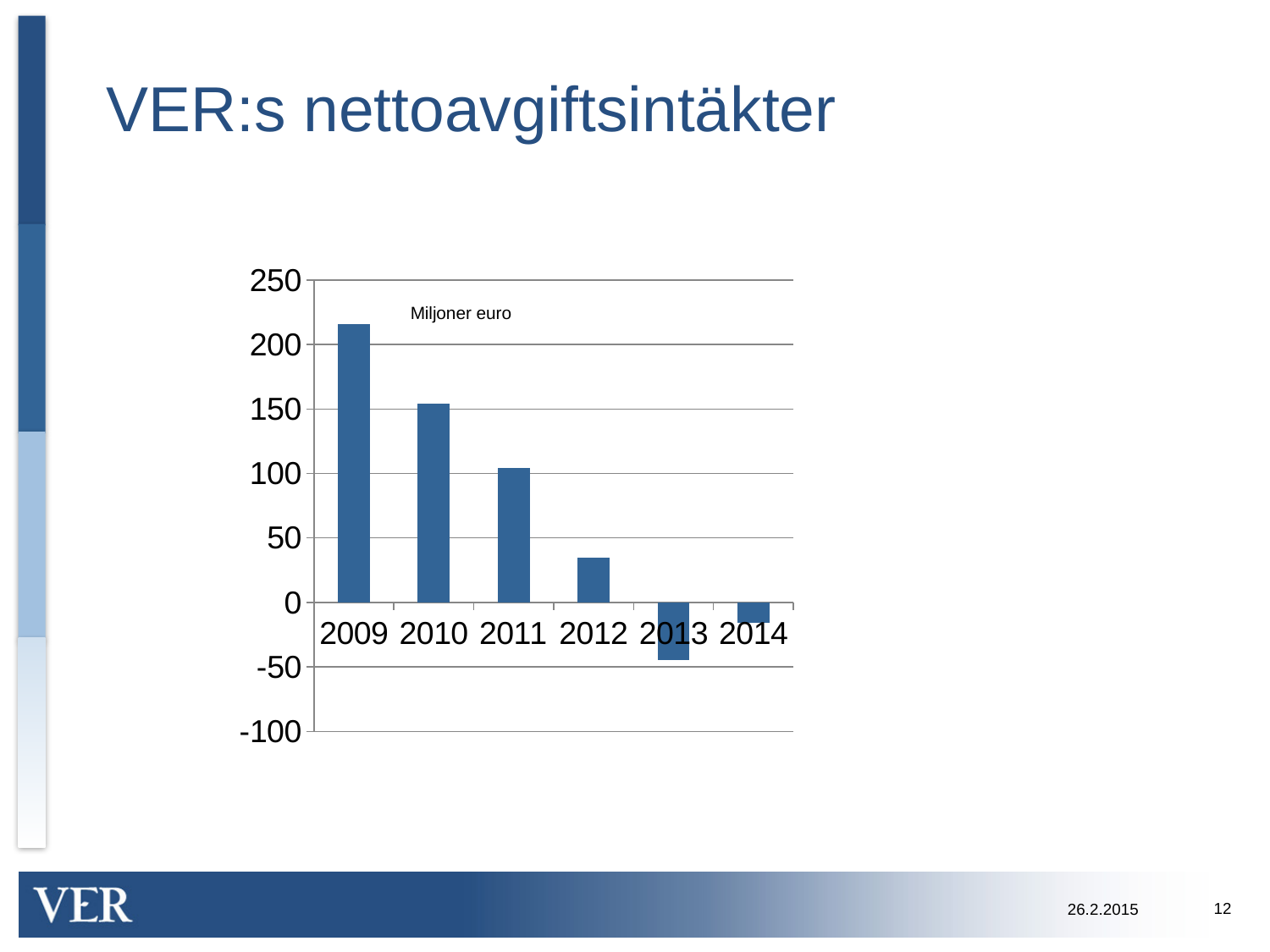
What kind of chart is shown on the slide? bar chart Is the value for 2009 greater or less than 200? greater Is the value for 2013 greater or less than 0? less Is the value for 2010 greater or less than 150? greater What unit label is printed inside the chart area? Miljoner euro Which year has the larger value, 2010 or 2011? 2010 How many years are shown on the x axis of the chart? 6 Do the values rise or fall from 2009 to 2013? fall Which year has the highest value in the chart? 2009 Which year has the lowest value in the chart? 2013